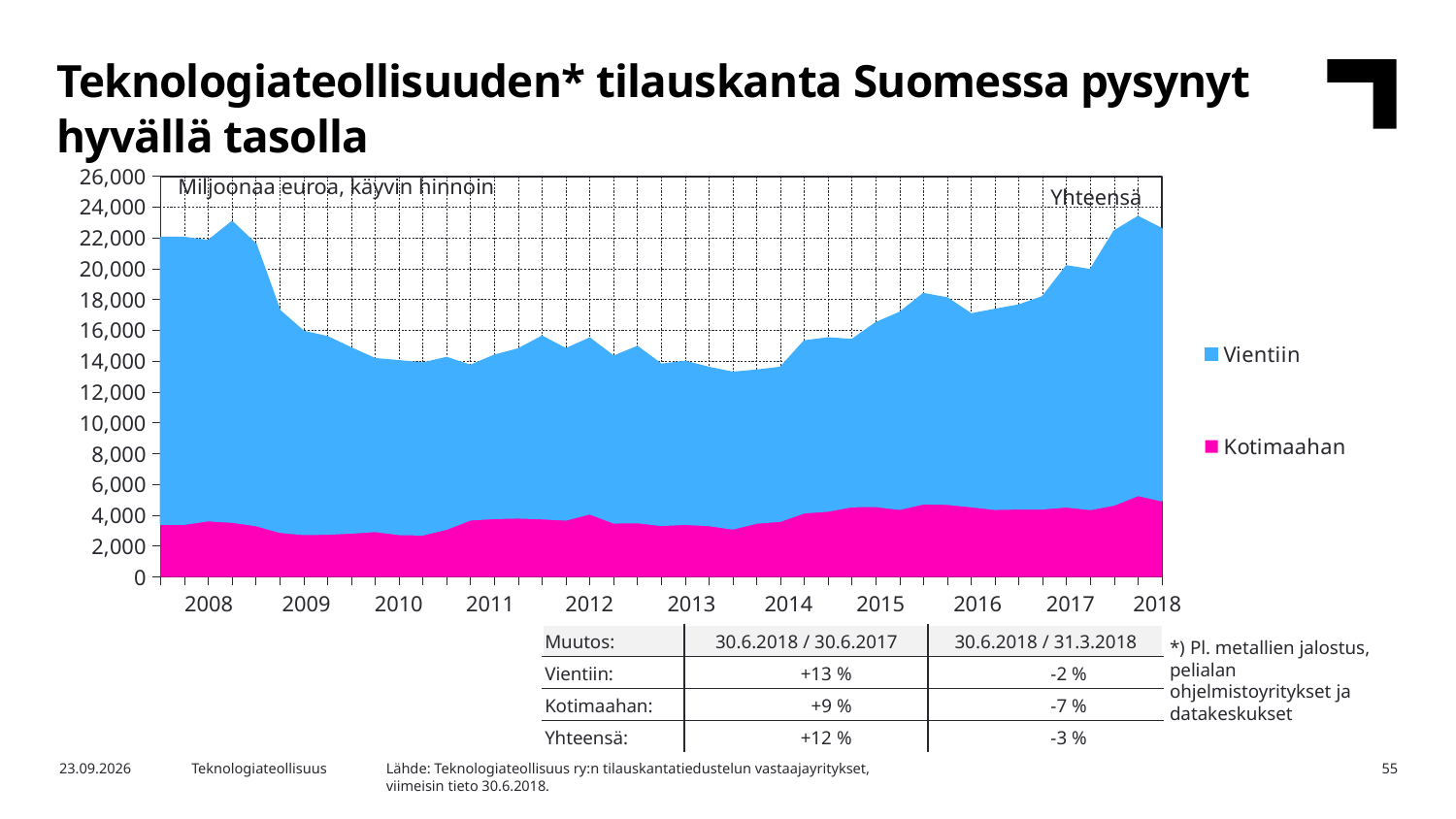
How many year labels are shown on the x axis? 11 What unit label is printed inside the chart area? Miljoonaa euroa, käyvin hinnoin Does the total order book (Yhteensä) rise or fall between 2016 and 2018? rise Which series is larger throughout the chart, Vientiin or Kotimaahan? Vientiin What are the two series named in the chart legend? Vientiin and Kotimaahan Is the total (Yhteensä) value at the start of 2008 greater or less than 20,000? greater What kind of chart is shown on the slide? Stacked area chart How many series does the chart legend list? 2 Is the total (Yhteensä) value at the end of the series in 2018 greater or less than 20,000? greater Is the total (Yhteensä) value in 2013 greater or less than 16,000? less Does the total order book (Yhteensä) rise or fall between 2008 and 2010? fall